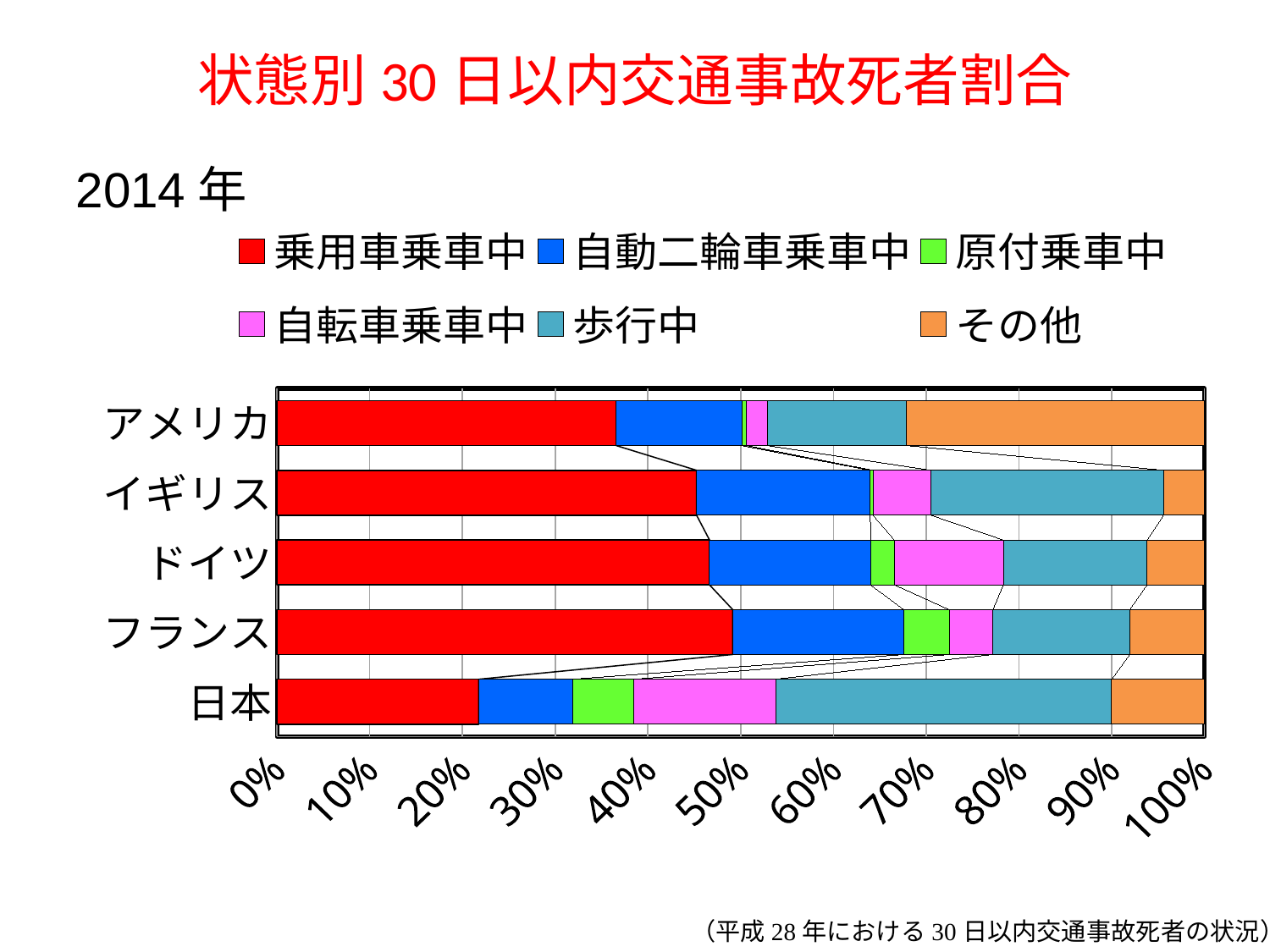
Which country has the largest share for 自転車乗車中? 日本 Which year does the chart show data for? 2014年 How many countries are shown on the chart? 5 Which country has the largest share for 歩行中? 日本 Which country has the larger 歩行中 share, イギリス or ドイツ? イギリス How many series does the legend list? 6 What kind of chart is shown on the slide? Stacked bar chart Which country has the smallest share for 乗用車乗車中? 日本 Is the 歩行中 share for 日本 greater or less than 30%? greater Is the 乗用車乗車中 share for アメリカ greater or less than 40%? less Is the 乗用車乗車中 share for 日本 greater or less than 30%? less Which country has the largest share for その他? アメリカ